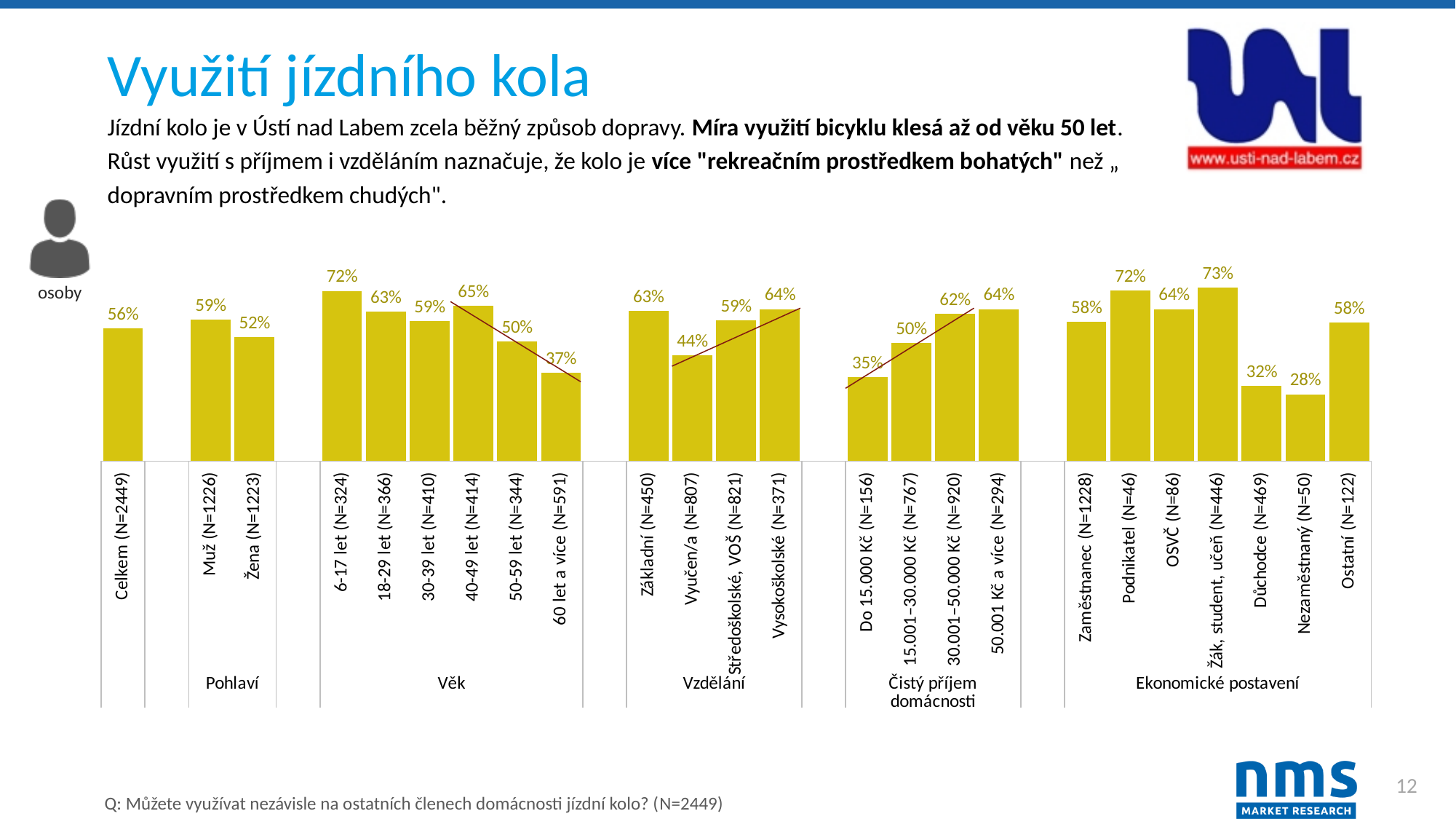
Which is larger, the value for Základní or the value for Vysokoškolské? Vysokoškolské Which category has the lowest value on the chart? Nezaměstnaný (N=50) What kind of chart is shown on the slide? bar chart Which category has the highest value on the chart? Žák, student, učeň (N=446) How many bars are plotted on the chart? 24 What is the value for Do 15.000 Kč (N=156)? 35% What is the difference between the values for Podnikatel and Důchodce? 40% Within the Čistý příjem domácnosti group, do the values rise or fall from the lowest to the highest income band? rise What is the value for the 60 let a více age group? 37% What is the value for Vyučen/a (N=807)? 44% What is the difference between the values for Muž and Žena? 7% What is the value for Celkem (N=2449)? 56%